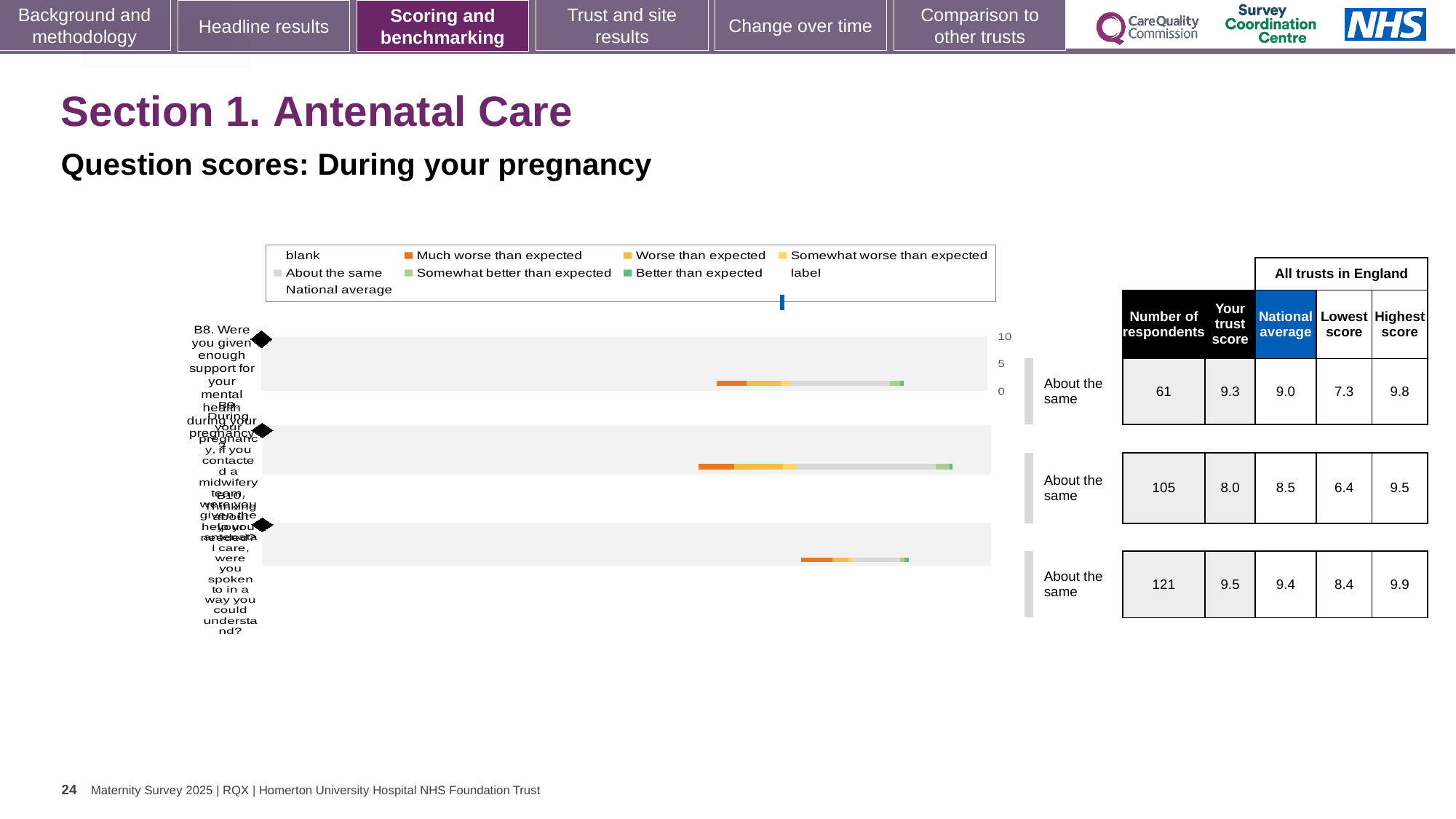
Which row in the table has the highest number of respondents? The third (bottom) row, 121 What colour does the legend use for 'Much worse than expected'? Orange For the first (top) question, what is the difference between the highest score and the lowest score across all trusts in England? 2.5 For the first (top) question, which is larger: the trust score or the national average? Trust score In the table beside the chart, what is the trust score for the first (top) question, B8? 9.3 In the table beside the chart, how many respondents are listed for the first (top) question, B8? 61 What is the maximum value shown on the chart's score axis? 10 How many bars (questions) are plotted in the chart? 3 In the table beside the chart, what is the national average for the second (middle) question? 8.5 For the second (middle) question, which is larger: the trust score or the national average? National average What benchmark category is shown for all three questions on the slide? About the same What kind of chart is shown on the slide? Bar chart